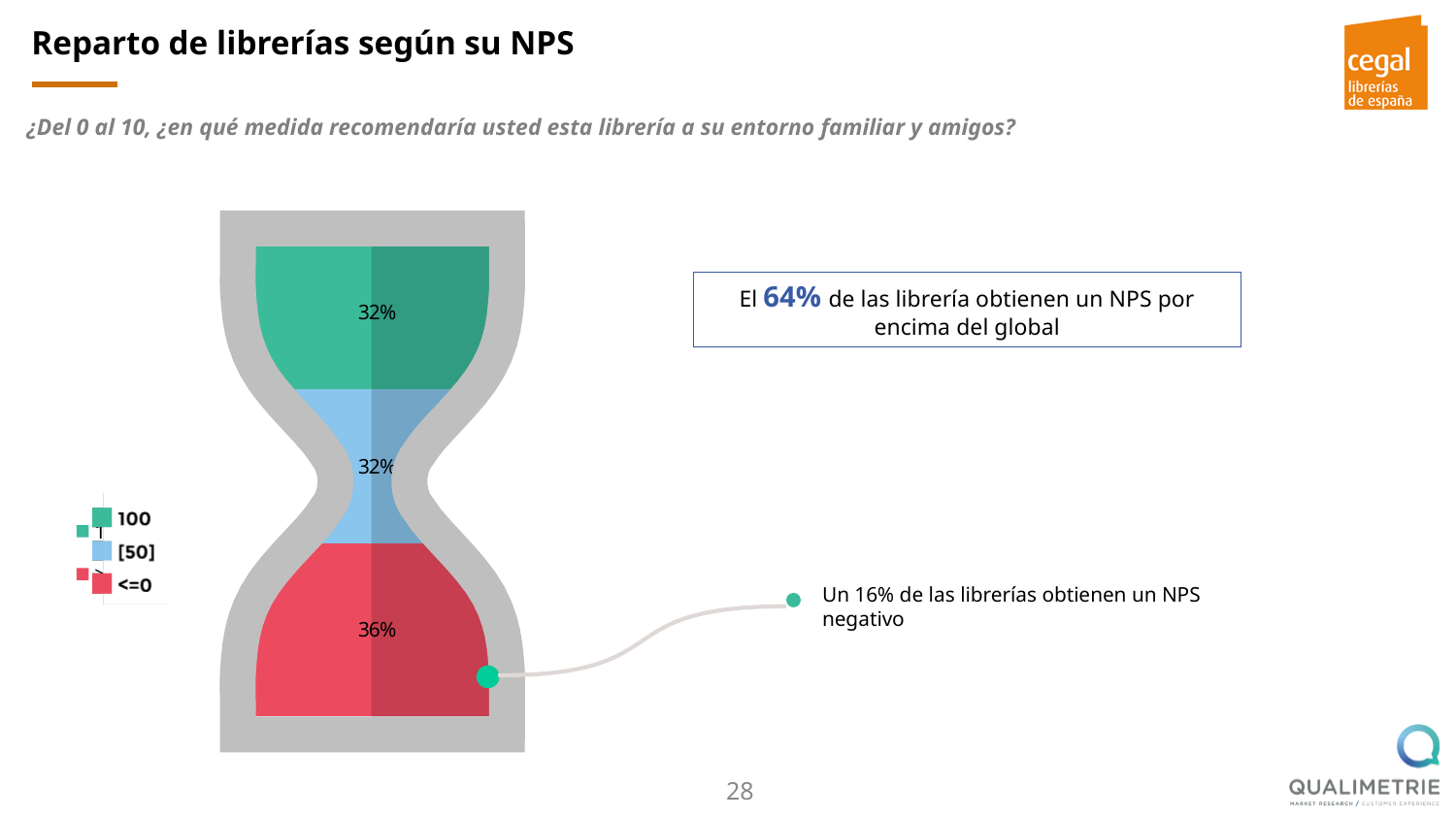
What colour is the segment labelled '<=0' in the legend? Red Which segment of the hourglass chart has the largest percentage? The bottom (red) segment, 36% What percentage is shown for the top (green) segment of the hourglass chart? 32% What is the difference in percentage points between the bottom (red) segment and the top (green) segment? 4 percentage points How many segments does the hourglass chart have? 3 What is the total of the three percentages shown in the hourglass chart? 100% What percentage is shown for the bottom (red) segment of the hourglass chart? 36% What percentage is shown for the middle (blue) segment of the hourglass chart? 32% Which is larger, the red segment or the green segment of the hourglass chart? The red segment How many entries does the legend of the chart list? 3 What is the title of the slide containing the hourglass chart? Reparto de librerías según su NPS